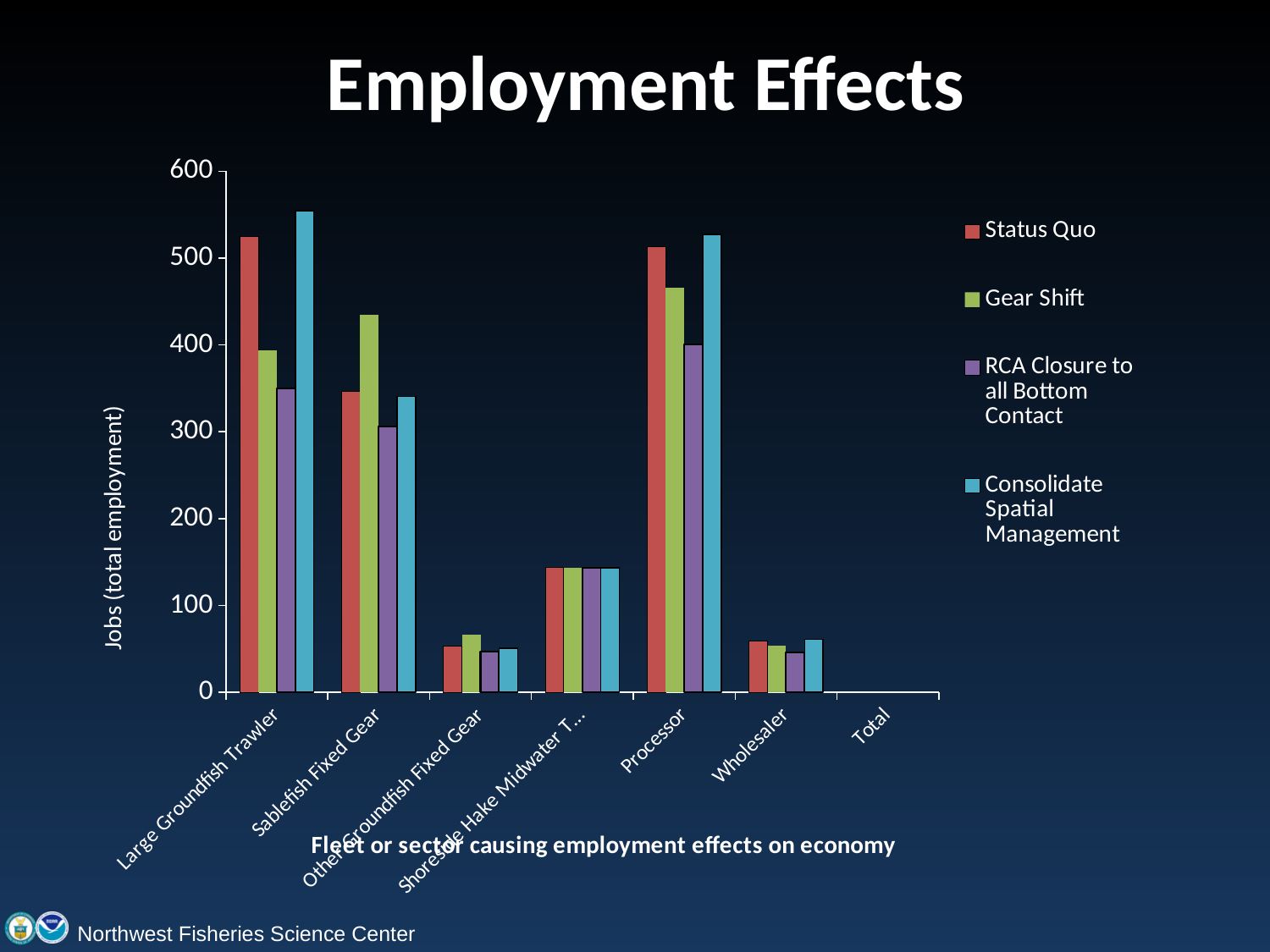
Is the Gear Shift value for Sablefish Fixed Gear greater or less than 400? greater How many categories are labelled along the x axis? 7 Which series has the highest value for Large Groundfish Trawler? Consolidate Spatial Management Is the Status Quo value for Wholesaler greater or less than 100? less What is the label of the y axis? Jobs (total employment) Is the Consolidate Spatial Management value for Large Groundfish Trawler greater or less than 500? greater Which is larger, the Status Quo value for Large Groundfish Trawler or the Status Quo value for Sablefish Fixed Gear? Large Groundfish Trawler Which series has the highest value for Sablefish Fixed Gear? Gear Shift Which series has the lowest value for Large Groundfish Trawler? RCA Closure to all Bottom Contact How many series does the legend list? 4 What kind of chart is shown on the slide? Bar chart